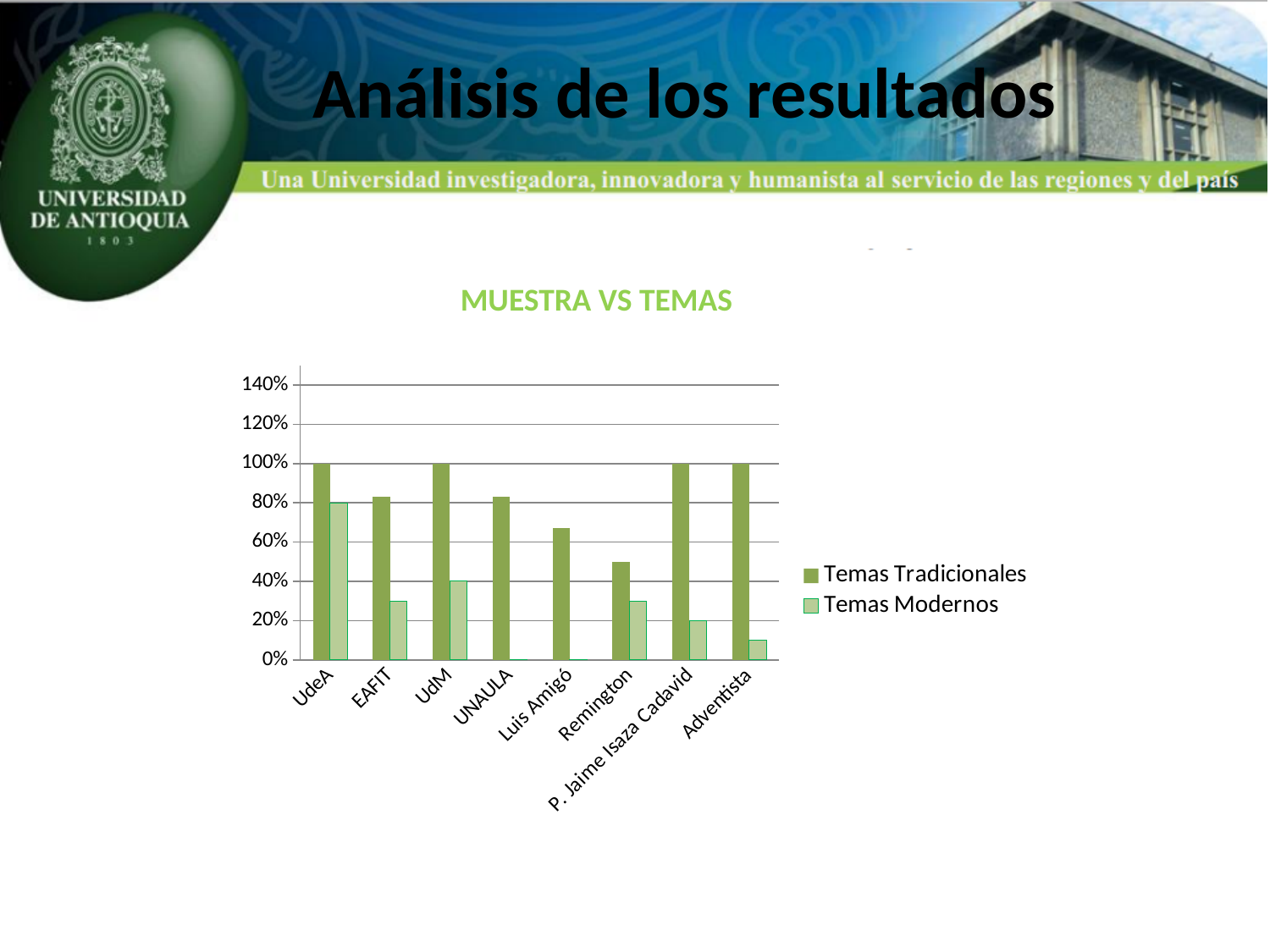
Which category has the highest value for Temas Modernos? UdeA What is the value of Temas Modernos for UdeA? 80% Which category has the lowest value for Temas Tradicionales? Remington Is the value of Temas Tradicionales for EAFIT greater or less than 60%? greater Which is larger for Remington: Temas Tradicionales or Temas Modernos? Temas Tradicionales How many categories are shown on the x axis? 8 How many series does the legend list? 2 What is the value of Temas Tradicionales for UdeA? 100% What is the value of Temas Modernos for UdM? 40% Is the value of Temas Tradicionales for Luis Amigó greater or less than 80%? less What kind of chart is shown on the slide? bar chart What is the title of the chart? MUESTRA VS TEMAS